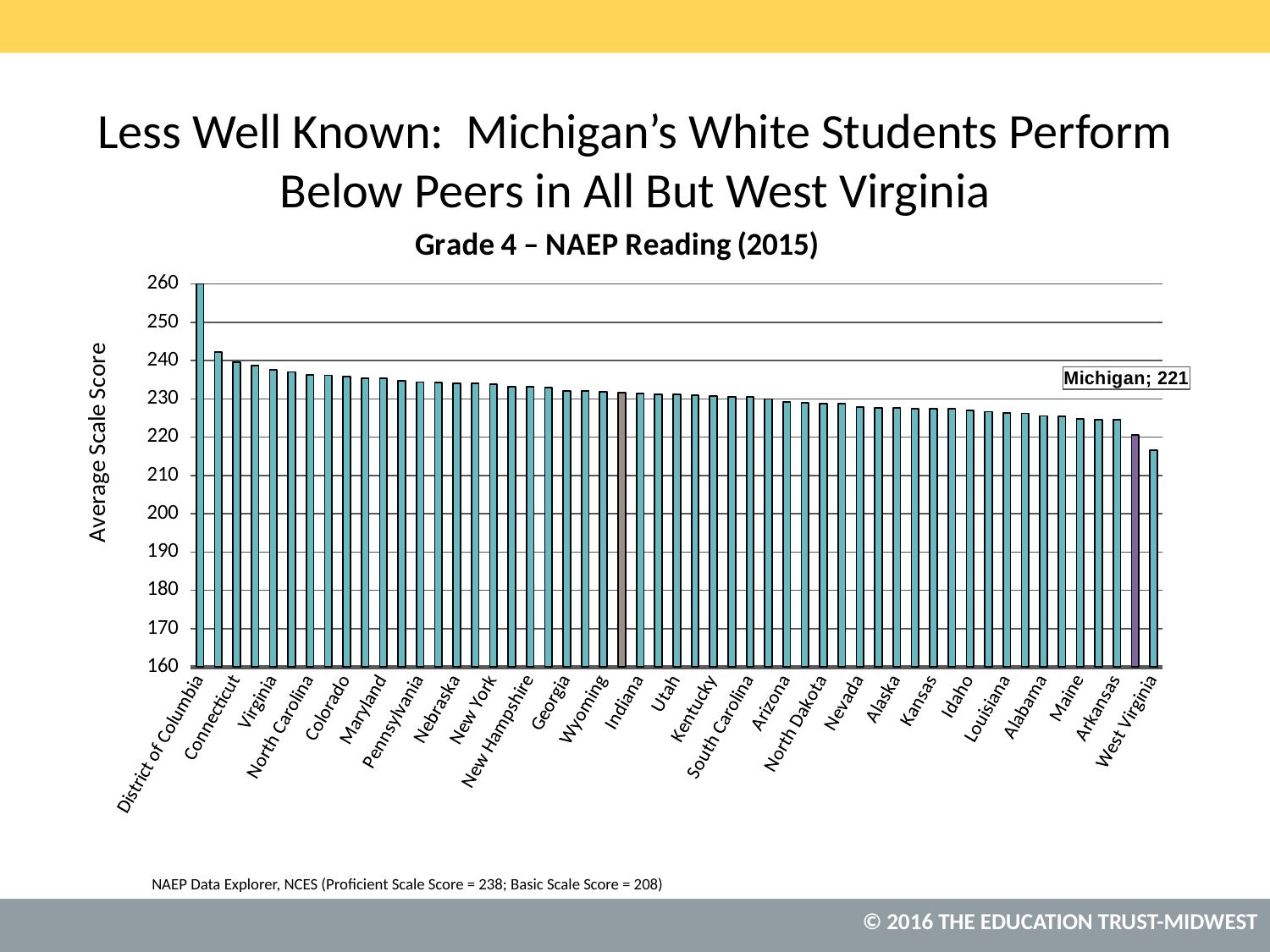
Which is larger, the value for Michigan or the value for West Virginia? Michigan What is the value for Michigan? 221 Is the value for District of Columbia greater or less than 250? greater Which state has the highest average scale score? District of Columbia Is the value for Maine greater or less than 230? less What is the title of the chart? Grade 4 – NAEP Reading (2015) Which state has the lowest average scale score? West Virginia Is the value for West Virginia greater or less than 220? less What kind of chart is shown on the slide? bar chart Which is larger, the value for Connecticut or the value for Arkansas? Connecticut Do the values rise or fall moving from left to right along the x axis? fall